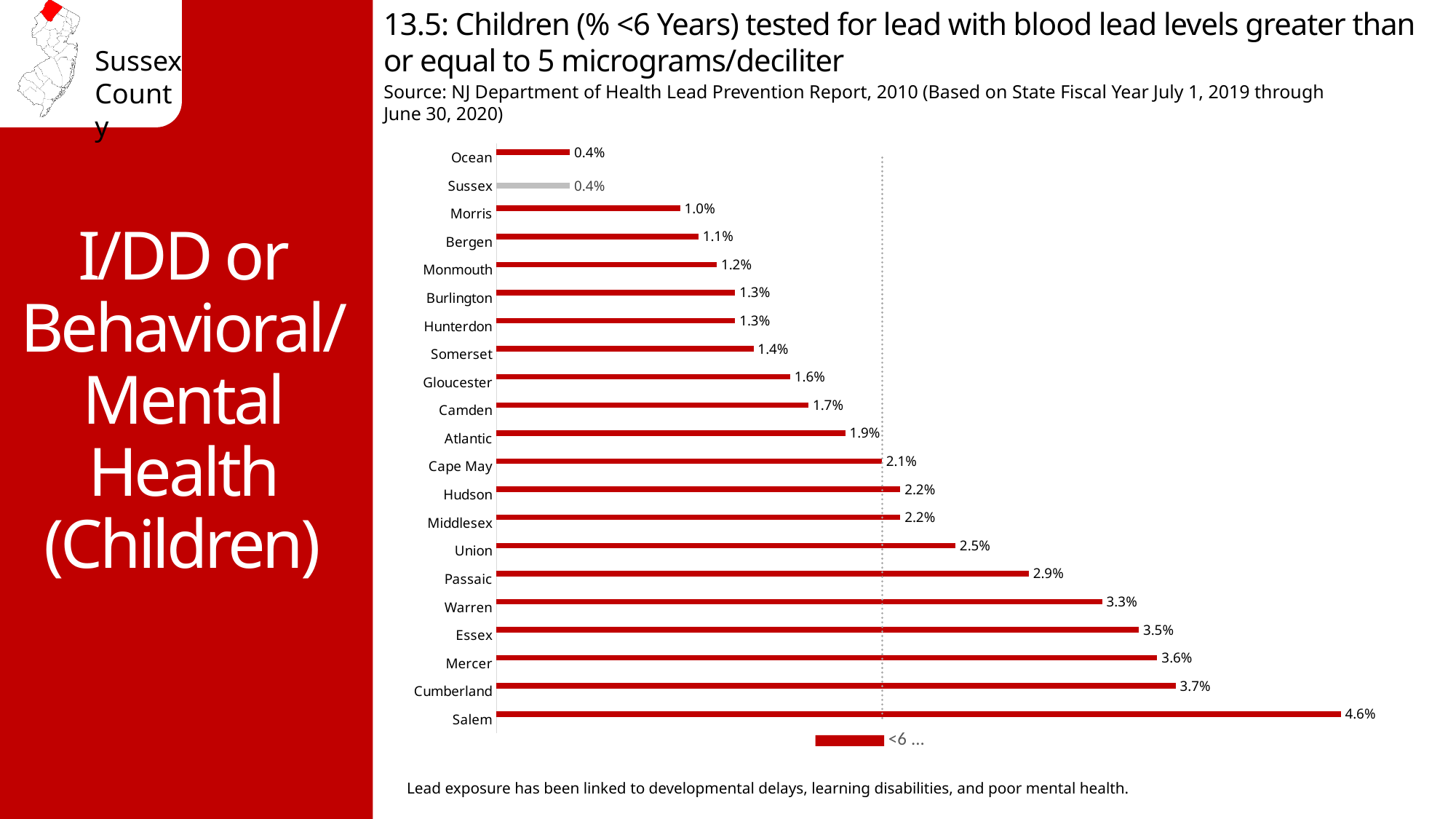
Which county's bar is shown in grey instead of red? Sussex Do the values increase or decrease going from the top bar (Ocean) to the bottom bar (Salem)? Increase What is the value for Passaic? 2.9% What kind of chart is shown on the slide? Bar chart Which has a larger value, Union or Atlantic? Union What is the value for Warren? 3.3% What is the value for Sussex? 0.4% Which county has the highest value? Salem How many counties are shown in the chart? 21 What is the difference between the values for Salem and Sussex? 4.2 percentage points Which has a larger value, Mercer or Essex? Mercer What is the value for Salem? 4.6%